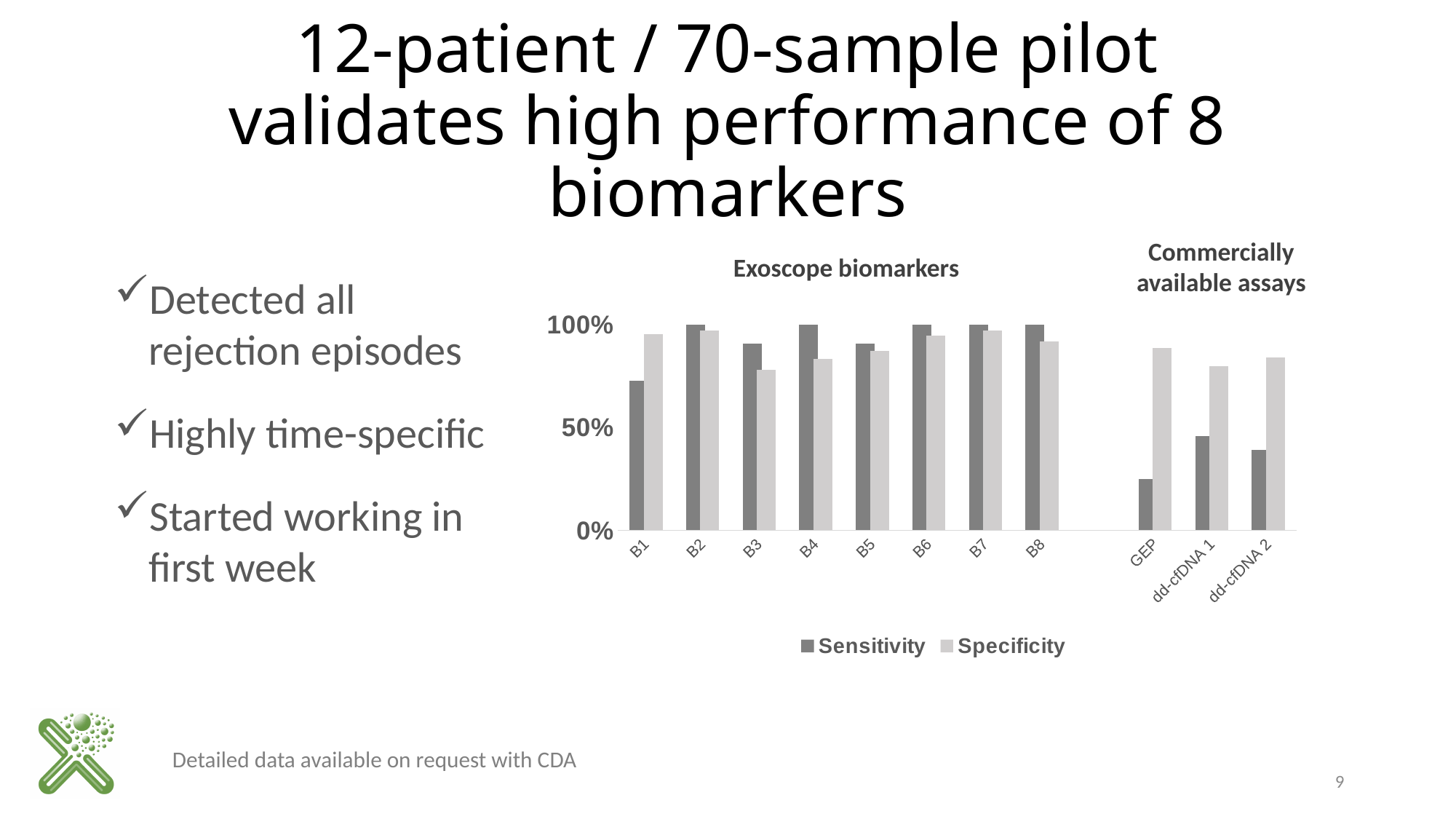
Is the Sensitivity value for dd-cfDNA 2 greater or less than 50%? less How many categories are plotted along the x axis of the chart? 11 What are the two group headings shown above the chart? Exoscope biomarkers and Commercially available assays What is the Sensitivity value for B7? 100% What are the two series named in the chart legend? Sensitivity and Specificity For B1, which is larger: Sensitivity or Specificity? Specificity What is the Sensitivity value for B2? 100% Is the Sensitivity value for GEP greater or less than 50%? less What kind of chart is shown on the slide? Bar chart Is the Specificity value for GEP greater or less than 50%? greater Which category has the lowest Sensitivity? GEP How many series does the chart legend list? 2